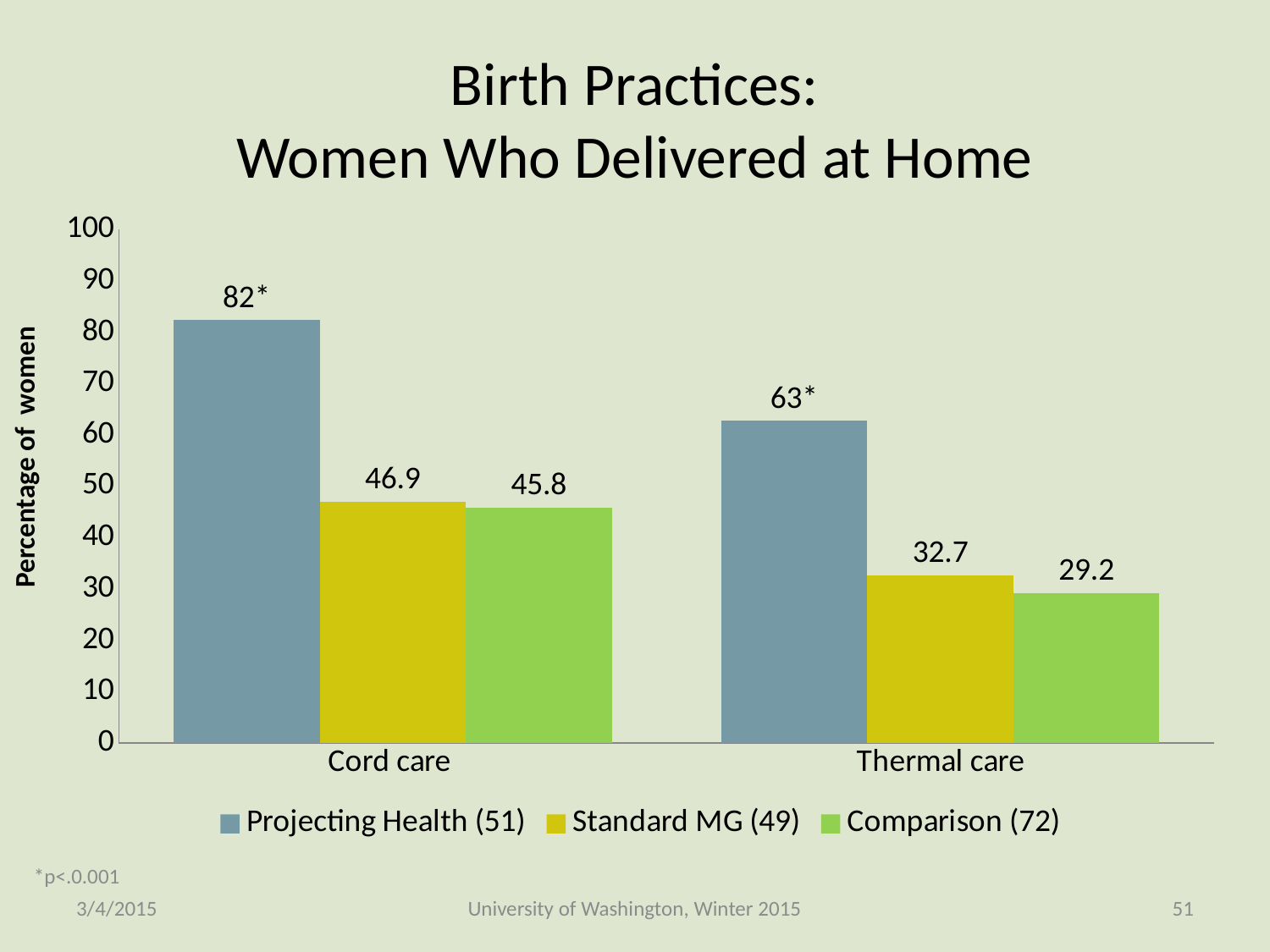
What is the difference between the Standard MG (49) and Comparison (72) values for Thermal care? 3.5 What is the value for Comparison (72) for Cord care? 45.8 Is the value for Comparison (72) for Thermal care greater or less than 30? less How many categories are shown on the x axis? 2 Which series has the highest value for Thermal care? Projecting Health (51) Which series has the lowest value for Thermal care? Comparison (72) What is the value for Standard MG (49) for Thermal care? 32.7 What is the difference between the Projecting Health (51) values for Cord care and Thermal care? 19 How many series does the legend list? 3 What kind of chart is shown on the slide? bar chart What is the value for Projecting Health (51) for Cord care? 82* Which is larger: the Standard MG (49) value for Cord care or the Standard MG (49) value for Thermal care? Cord care